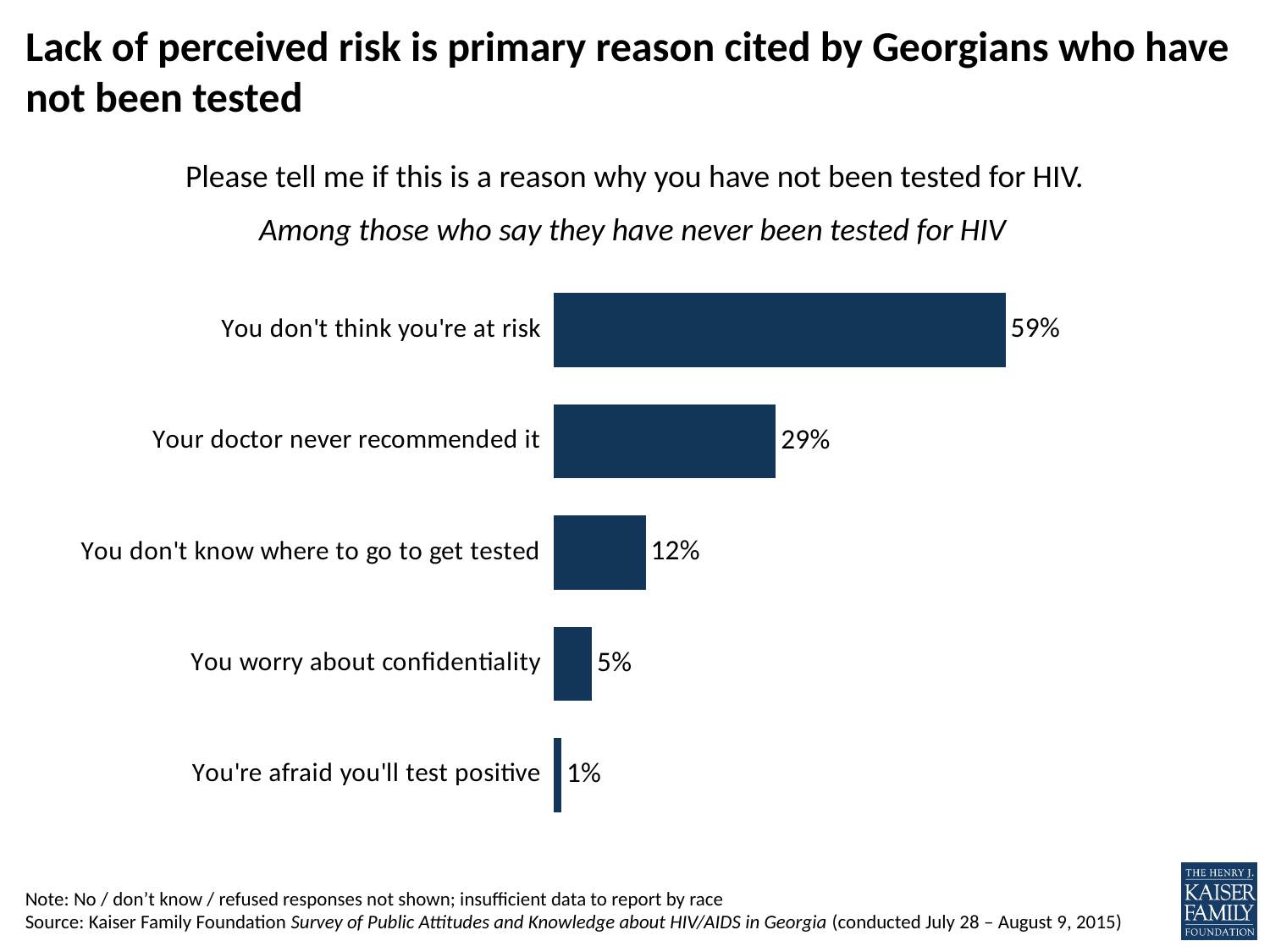
What percentage said they're afraid they'll test positive? 1% Which reason has the highest percentage? You don't think you're at risk What percentage said they don't know where to go to get tested? 12% What percentage of respondents said they don't think they're at risk as a reason for not being tested? 59% Which reason has the lowest percentage? You're afraid you'll test positive What is the difference in percentage points between 'You don't think you're at risk' and 'Your doctor never recommended it'? 30 What kind of chart is shown on the slide? Bar chart What is the difference in percentage points between 'You worry about confidentiality' and 'You're afraid you'll test positive'? 4 What percentage said their doctor never recommended it? 29% Which is larger: the value for 'You don't know where to go to get tested' or 'You worry about confidentiality'? You don't know where to go to get tested What percentage said they worry about confidentiality? 5% How many reasons are shown in the chart? 5